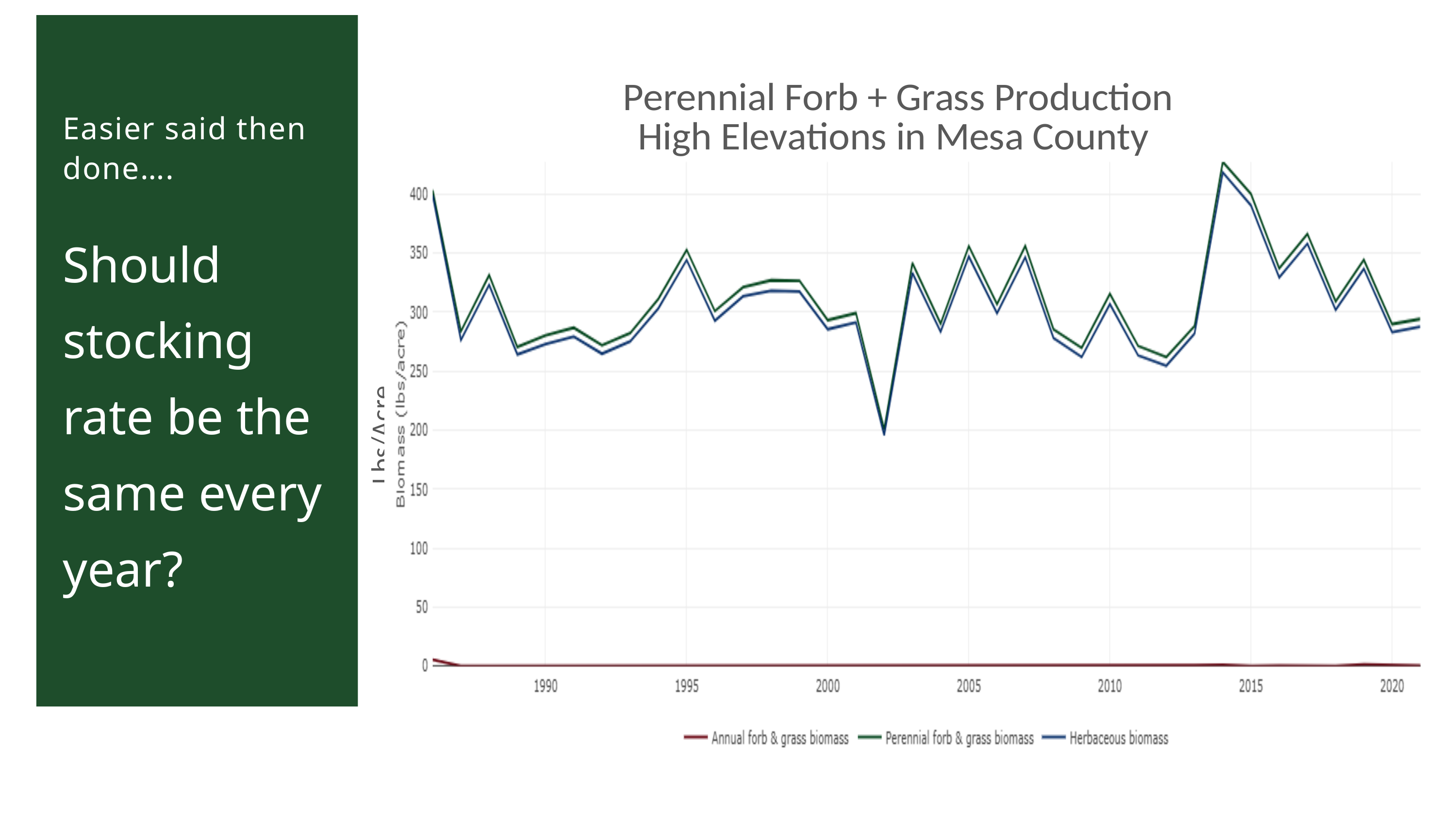
Which series stays lowest across all years on the chart? Annual forb & grass biomass What is the title of the chart? Perennial Forb + Grass Production High Elevations in Mesa County Which year has the larger Perennial forb & grass biomass value, 2014 or 2002? 2014 In which year does the Perennial forb & grass biomass series reach its highest value? 2014 How many series does the legend list? 3 In which year does the Perennial forb & grass biomass series reach its lowest value? 2002 Is the Perennial forb & grass biomass value in 2002 greater or less than 250? less Is the Perennial forb & grass biomass value in 1995 greater or less than 300? greater Is the Annual forb & grass biomass value in 2010 greater or less than 50? less What kind of chart is shown on the slide? Line chart Which series is plotted in red according to the legend? Annual forb & grass biomass